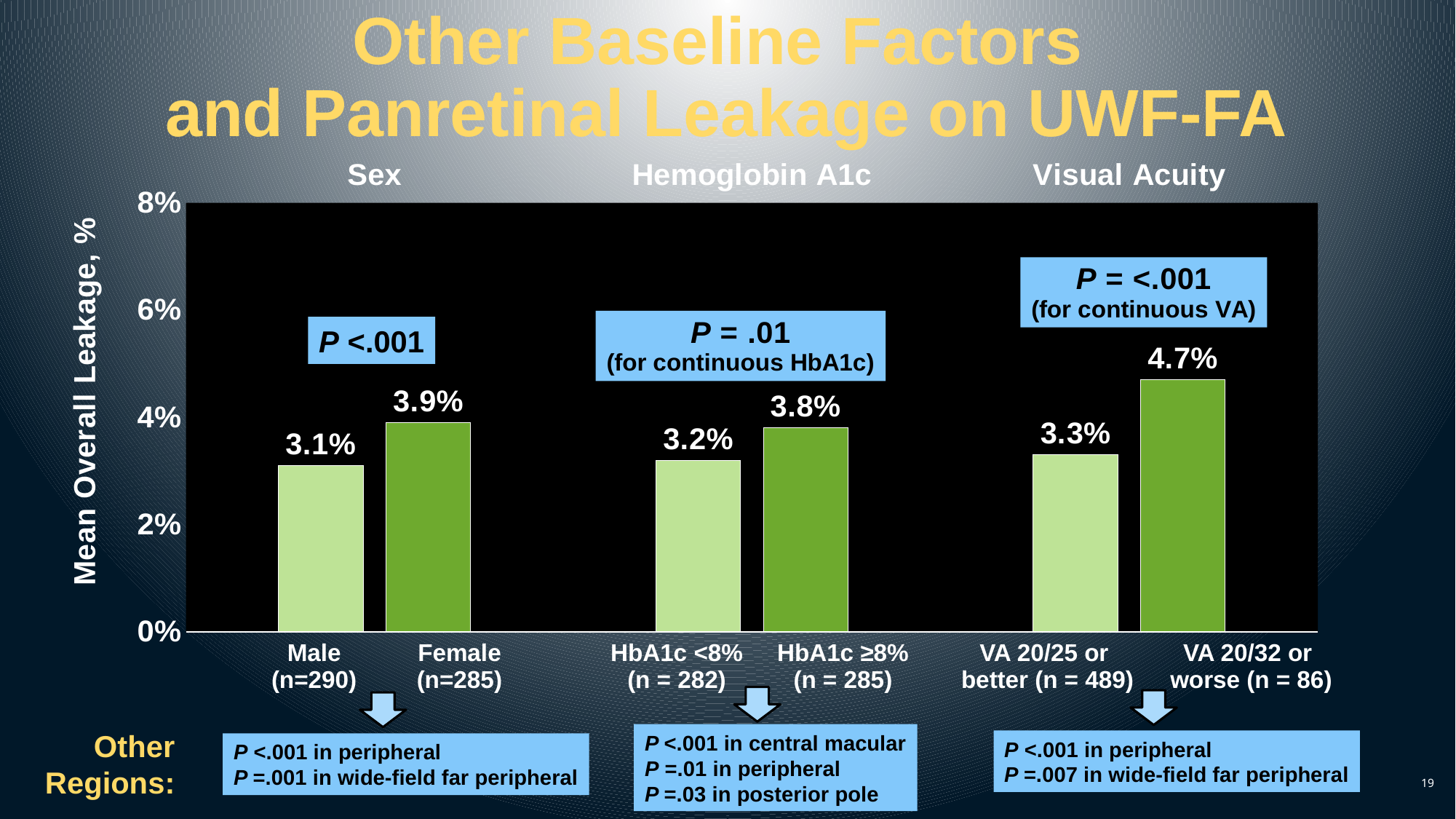
What is the mean overall leakage for Male (n=290)? 3.1% What kind of chart is shown on the slide? Bar chart Which category has the lowest mean overall leakage? Male How many bars are plotted in the chart? 6 Which category has the highest mean overall leakage? VA 20/32 or worse What is the label of the y axis? Mean Overall Leakage, % What is the difference in mean overall leakage between Female and Male? 0.8% What is the difference in mean overall leakage between VA 20/32 or worse and VA 20/25 or better? 1.4% Which has a higher mean overall leakage, HbA1c <8% or HbA1c ≥8%? HbA1c ≥8% What is the mean overall leakage for VA 20/32 or worse (n = 86)? 4.7% What is the mean overall leakage for Female (n=285)? 3.9% What is the mean overall leakage for HbA1c ≥8%? 3.8%